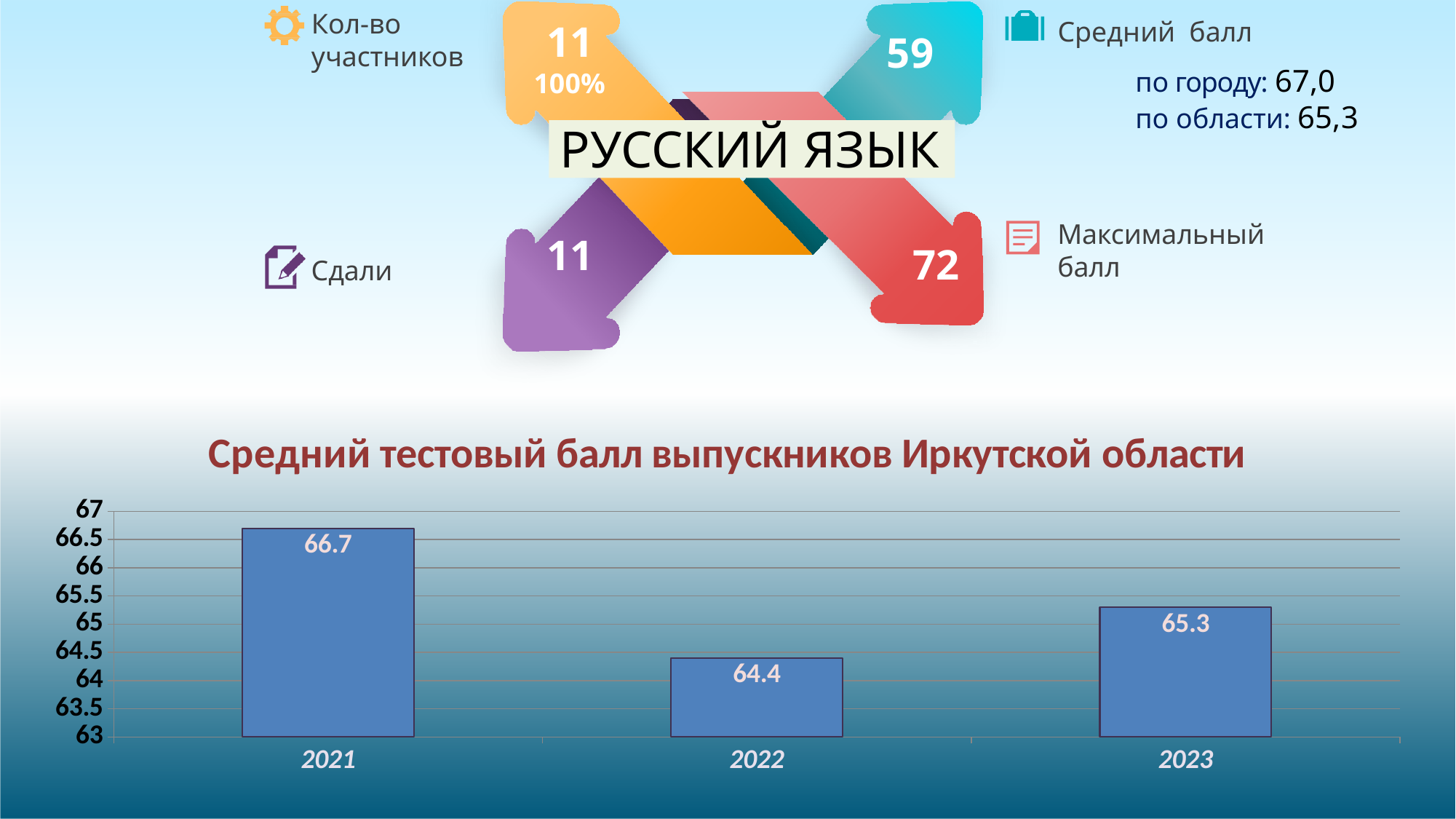
How many years are shown in the chart? 3 What is the difference between the values for 2023 and 2022? 0.9 What is the value for 2021 in the chart? 66.7 What is the difference between the values for 2021 and 2022? 2.3 Which is larger, the value for 2021 or the value for 2023? 2021 What is the title of the chart? Средний тестовый балл выпускников Иркутской области What is the value for 2023 in the chart? 65.3 Which year has the highest average test score in the chart? 2021 Is the value for 2022 greater or less than 65? less What is the value for 2022 in the chart? 64.4 Which year has the lowest average test score in the chart? 2022 What kind of chart is shown on the slide? bar chart